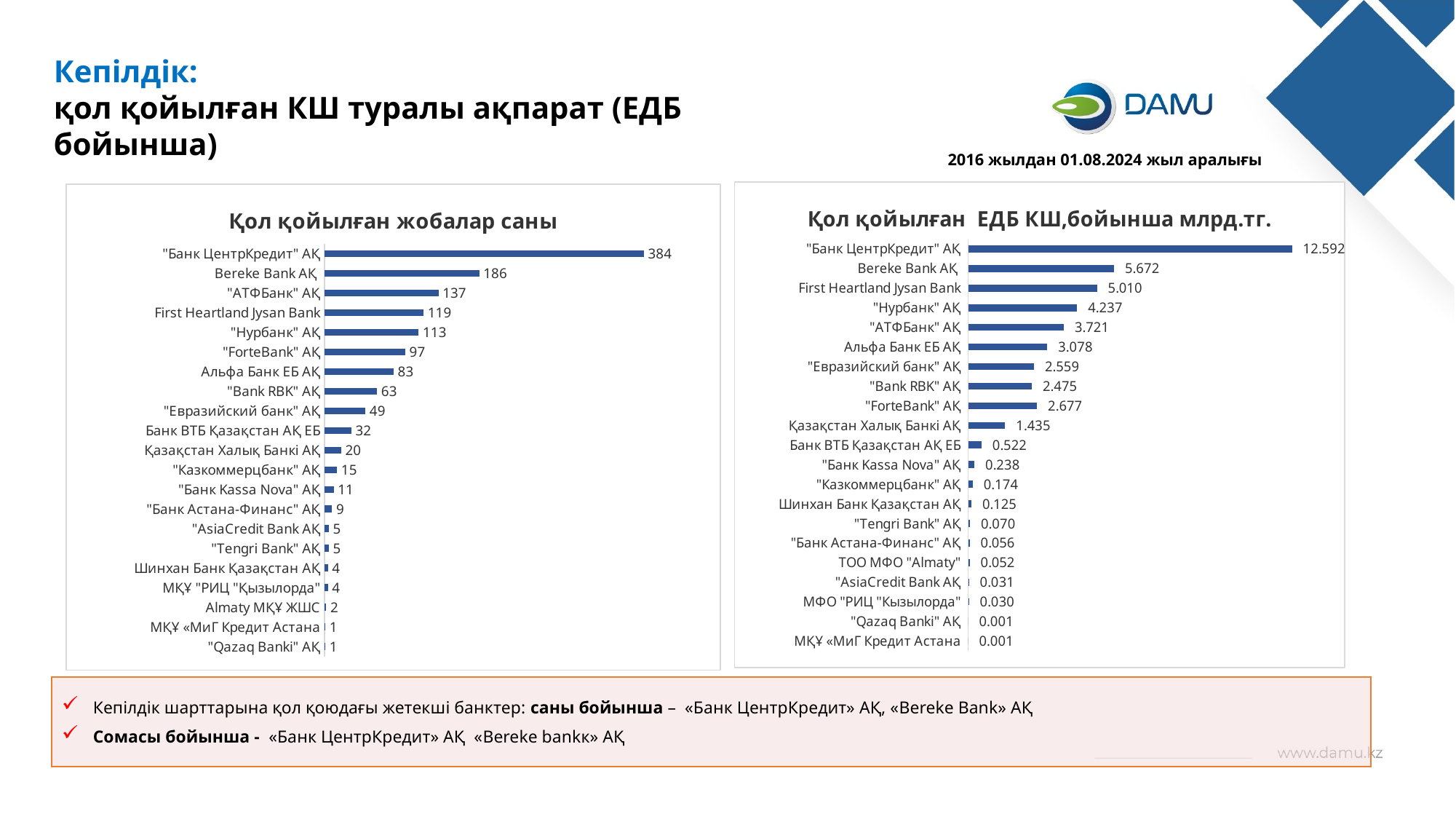
In the chart "Қол қойылған ЕДБ КШ,бойынша млрд.тг.", which bank has the highest value? "Банк ЦентрКредит" АҚ In the chart "Қол қойылған ЕДБ КШ,бойынша млрд.тг.", what is the difference between "Банк ЦентрКредит" АҚ and Bereke Bank АҚ? 6.920 In the chart "Қол қойылған ЕДБ КШ,бойынша млрд.тг.", which is larger: "ForteBank" АҚ or "Евразийский банк" АҚ? "ForteBank" АҚ In the chart "Қол қойылған жобалар саны", which is larger: "Нурбанк" АҚ or "ForteBank" АҚ? "Нурбанк" АҚ What type of chart is "Қол қойылған жобалар саны"? Bar chart In the chart "Қол қойылған ЕДБ КШ,бойынша млрд.тг.", what is the value for "Bank RBK" АҚ? 2.475 In the chart "Қол қойылған жобалар саны", what is the difference between "Банк ЦентрКредит" АҚ and Bereke Bank АҚ? 198 In the chart "Қол қойылған ЕДБ КШ,бойынша млрд.тг.", what is the value for First Heartland Jysan Bank? 5.010 In the chart "Қол қойылған жобалар саны", which bank has the highest value? "Банк ЦентрКредит" АҚ What is the title of the chart on the right side of the slide? Қол қойылған ЕДБ КШ,бойынша млрд.тг. In the chart "Қол қойылған жобалар саны", how many banks are listed? 21 In the chart "Қол қойылған жобалар саны", what is the value for "АТФБанк" АҚ? 137